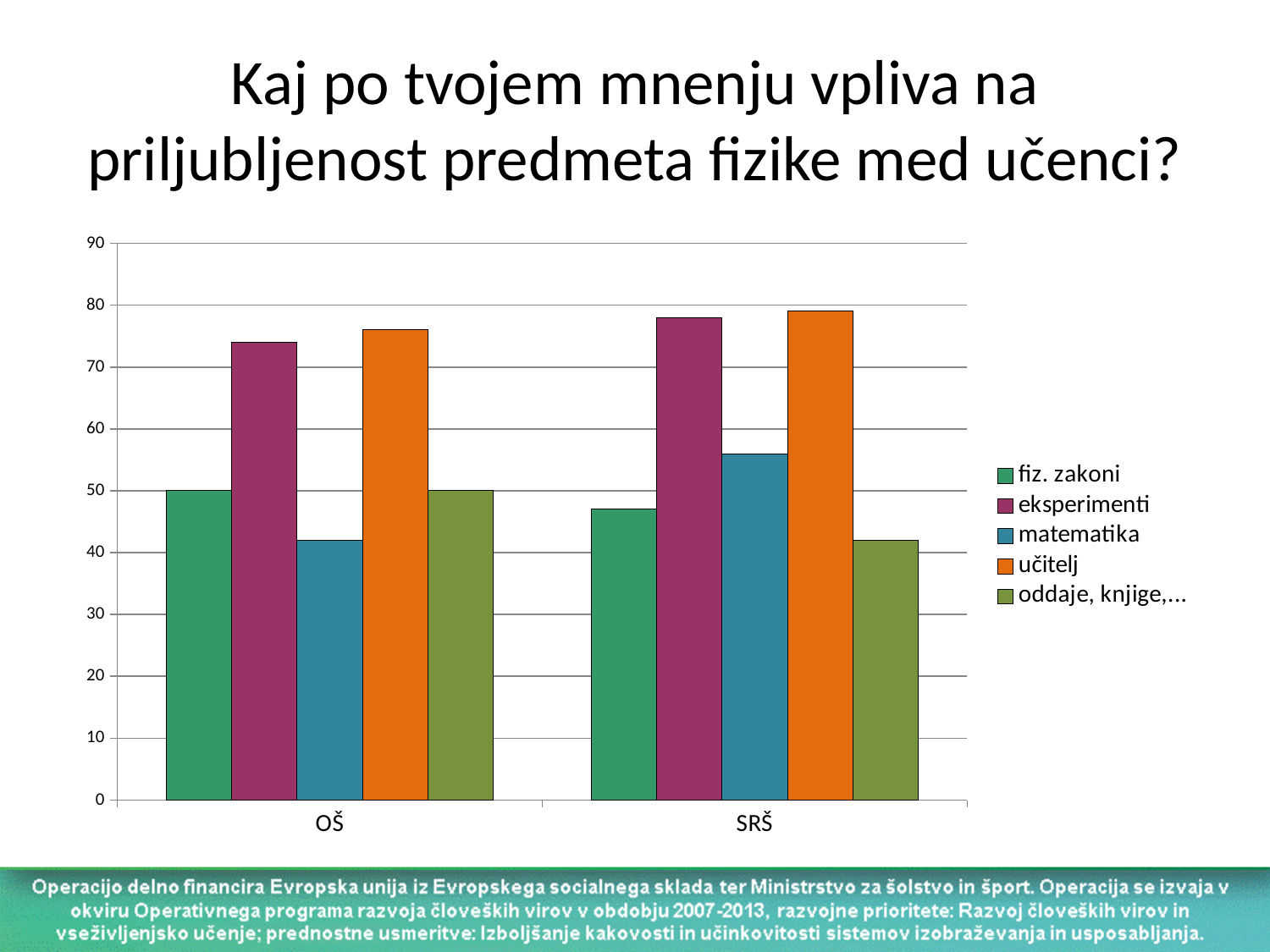
Which is larger for matematika: the OŠ value or the SRŠ value? SRŠ How many categories are shown on the x axis? 2 Which series has the lowest value in the SRŠ category? oddaje, knjige,... Does the value for matematika rise or fall from OŠ to SRŠ? rise Which series has the lowest value in the OŠ category? matematika Is the value for eksperimenti in the SRŠ category greater or less than 70? greater How many series does the legend list? 5 What kind of chart is shown on the slide? bar chart What is the value for oddaje, knjige,... in the OŠ category? 50 Is the value for matematika in the OŠ category greater or less than 50? less What is the value for fiz. zakoni in the OŠ category? 50 Is the value for učitelj in the SRŠ category greater or less than 70? greater